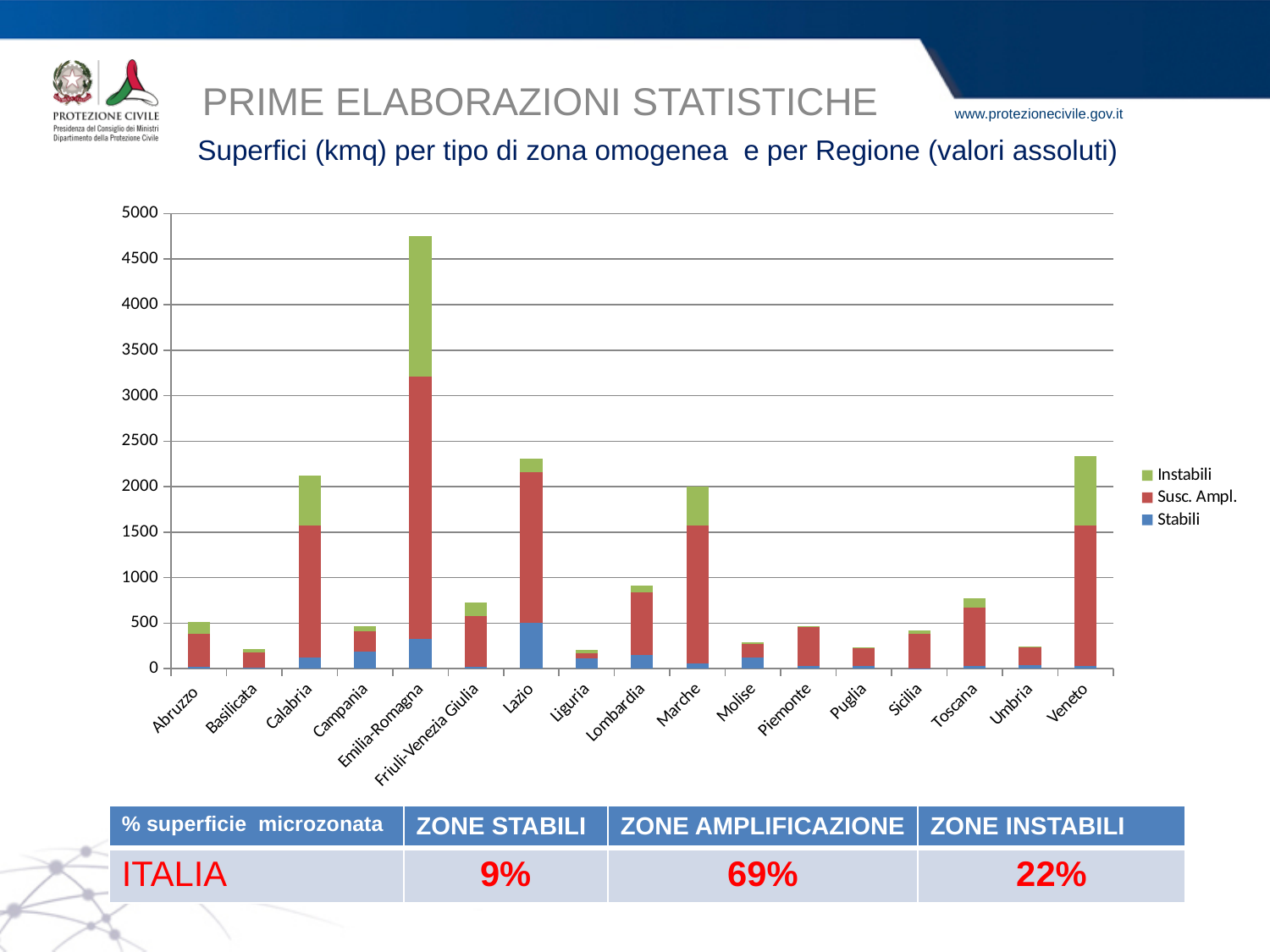
Which region has the taller bar, Emilia-Romagna or Lazio? Emilia-Romagna Is the total bar height for Lazio greater or less than 2000? greater Is the total bar height for Toscana greater or less than 1000? less Is the total bar height for Emilia-Romagna greater or less than 4500? greater Which series in the legend is shown in green? Instabili What kind of chart is shown on the slide? Stacked bar chart What is the subtitle describing the chart on the slide? Superfici (kmq) per tipo di zona omogenea e per Regione (valori assoluti) Which region has the tallest bar in the chart? Emilia-Romagna How many series does the chart legend list? 3 Which region has the taller bar, Veneto or Toscana? Veneto How many regions are shown along the x axis of the chart? 17